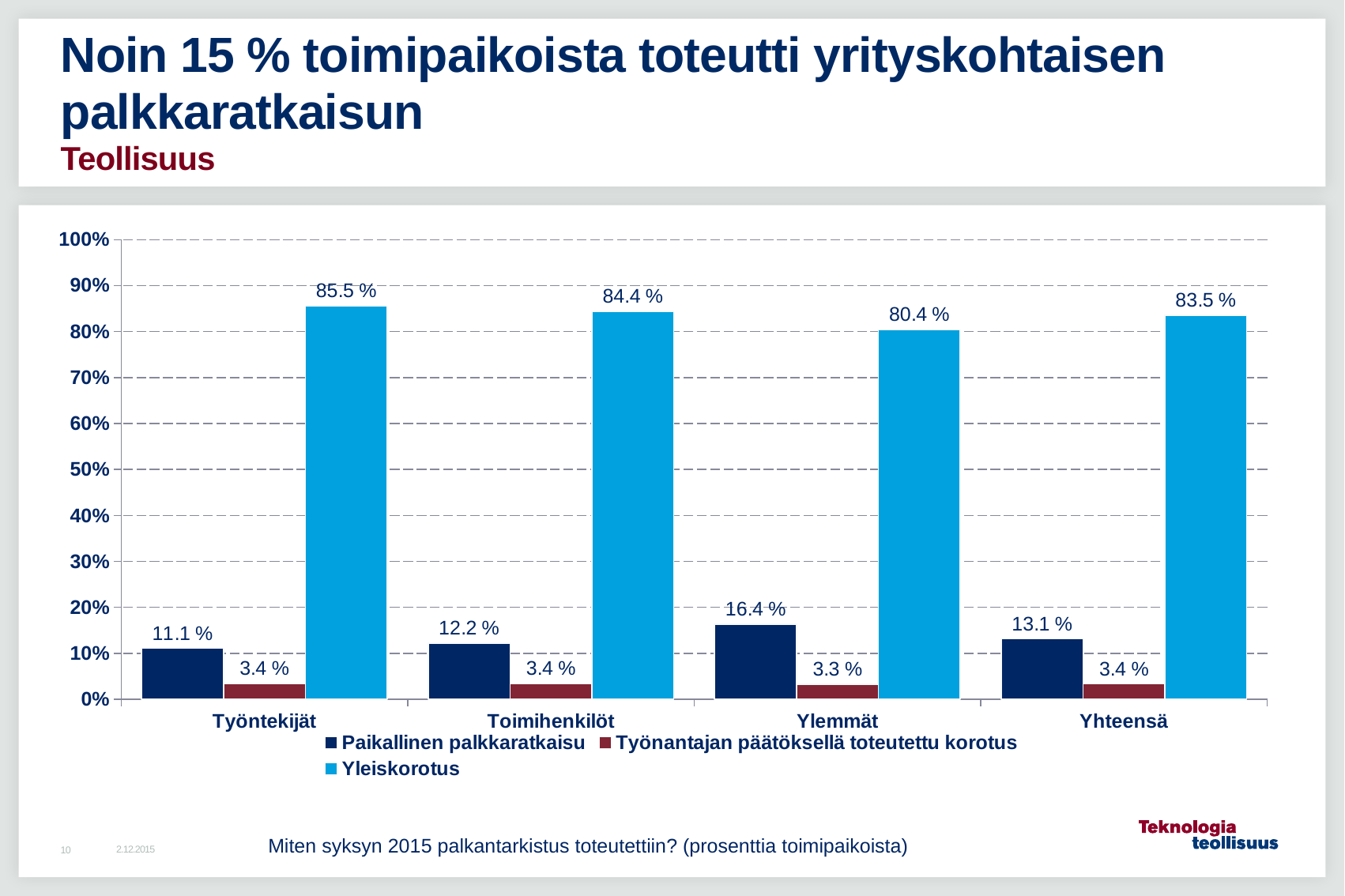
Which category has the lowest value for Yleiskorotus? Ylemmät Which category has the highest value for Paikallinen palkkaratkaisu? Ylemmät What is the difference between the Yleiskorotus values for Työntekijät and Ylemmät? 5.1 % What is the value of Paikallinen palkkaratkaisu for Yhteensä? 13.1 % How many series does the legend list? 3 What is the value of Työnantajan päätöksellä toteutettu korotus for Ylemmät? 3.3 % What is the value of Paikallinen palkkaratkaisu for Ylemmät? 16.4 % Which is larger: Paikallinen palkkaratkaisu for Toimihenkilöt or for Yhteensä? Yhteensä How many categories are shown on the x axis? 4 What kind of chart is shown on the slide? Bar chart What is the value of Yleiskorotus for Työntekijät? 85.5 % Which series is shown in light blue? Yleiskorotus